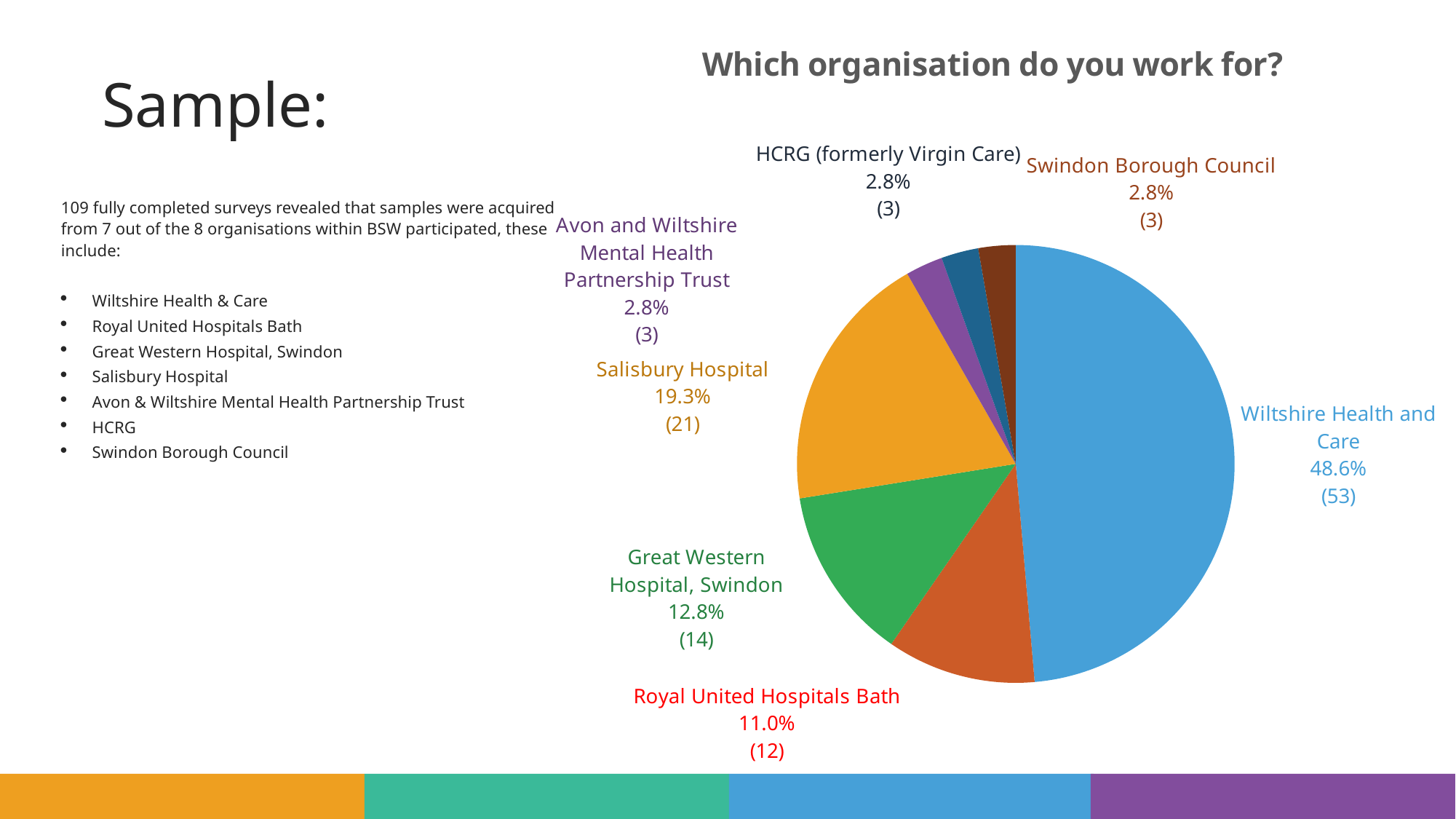
What is the combined number of respondents from HCRG (formerly Virgin Care) and Avon and Wiltshire Mental Health Partnership Trust? 6 Which has a larger share: Great Western Hospital, Swindon or Royal United Hospitals Bath? Great Western Hospital, Swindon What percentage of respondents work for Great Western Hospital, Swindon? 12.8% What percentage of respondents work for Swindon Borough Council? 2.8% How many respondents work for Royal United Hospitals Bath? 12 How many respondents work for Salisbury Hospital? 21 What kind of chart is shown on the slide? Pie chart How many organisations (slices) are shown in the pie chart? 7 What is the difference in respondent count between Wiltshire Health and Care and Salisbury Hospital? 32 Which organisation has the largest share of the pie? Wiltshire Health and Care What percentage of respondents work for Wiltshire Health and Care? 48.6% What is the title of the chart? Which organisation do you work for?